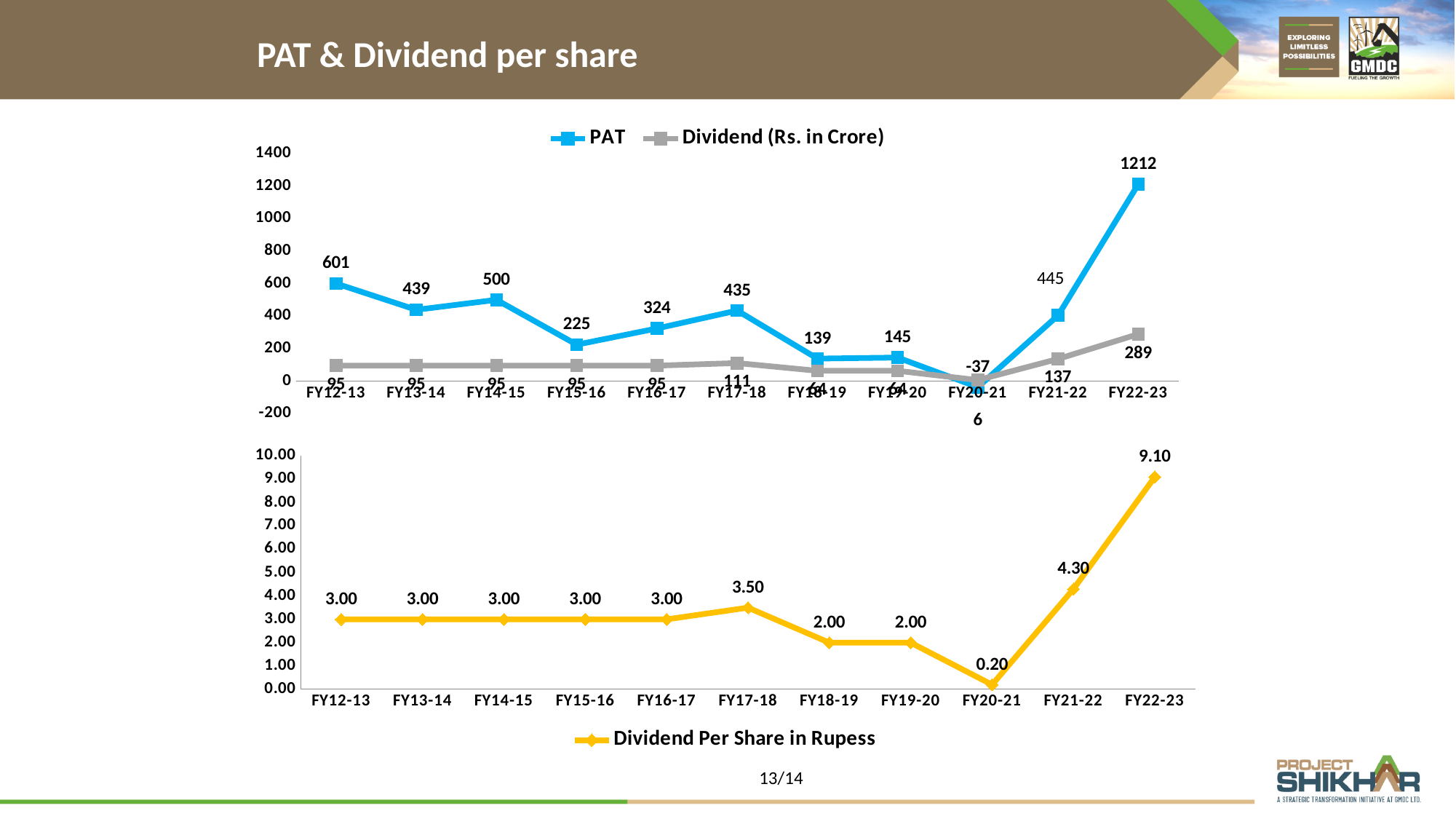
In the top chart, how many series does the legend list? 2 In the bottom chart, how many fiscal years are plotted on the x axis? 11 In the bottom chart, which fiscal year has the lowest Dividend Per Share? FY20-21 In the top chart, what is the difference between the PAT values for FY12-13 and FY13-14? 162 In the top chart, which fiscal year has the highest PAT? FY22-23 In the bottom chart, what is the difference between the Dividend Per Share for FY22-23 and FY21-22? 4.80 In the top chart, which fiscal year has the lowest PAT? FY20-21 In the top chart, what is the PAT value for FY22-23? 1212 In the bottom chart, what is the Dividend Per Share for FY21-22? 4.30 In the top chart, what is the PAT value for FY20-21? -37 What type of chart is the bottom chart? Line chart In the top chart, what is the Dividend (Rs. in Crore) value for FY21-22? 137